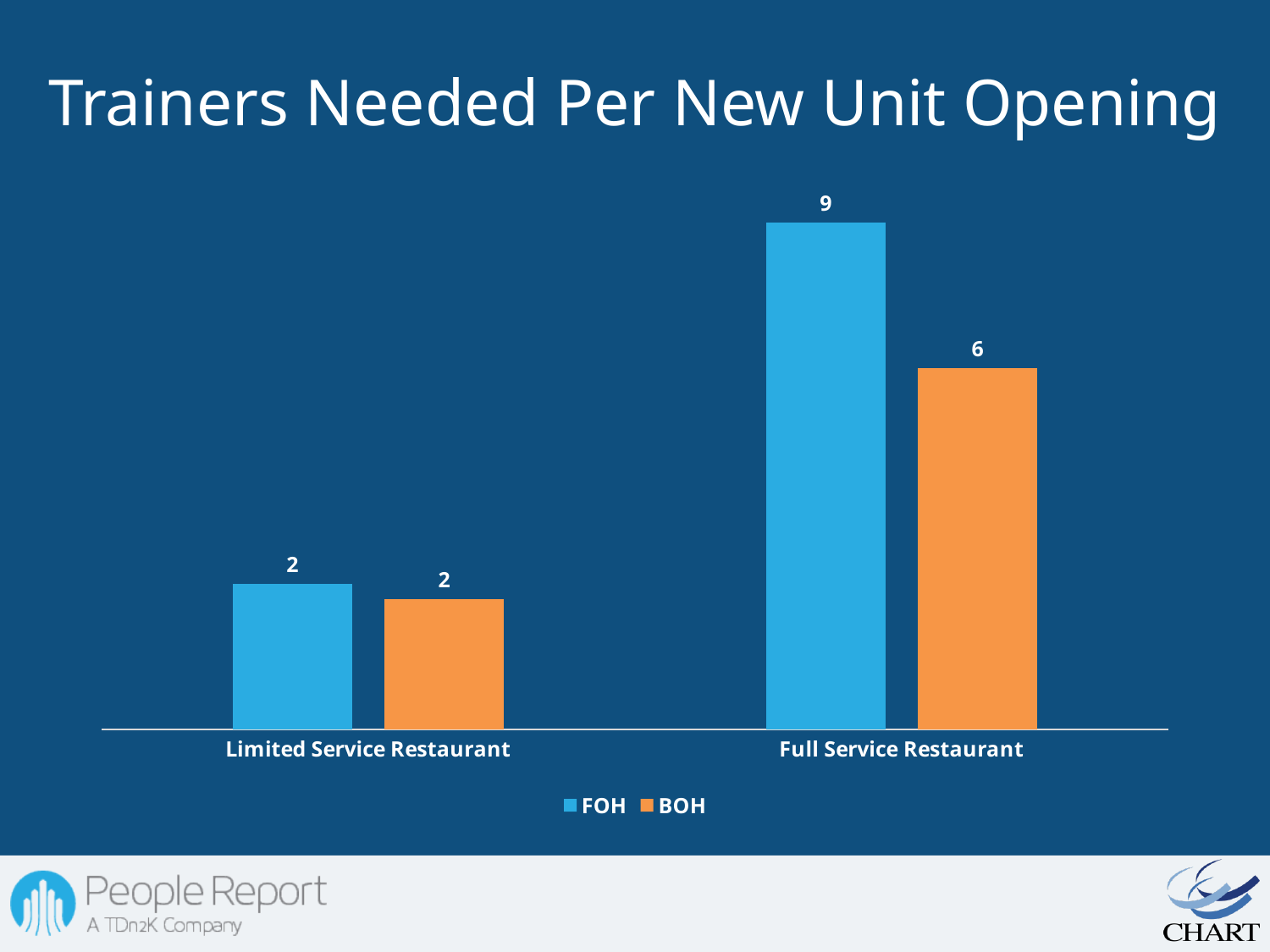
What is the difference between the FOH values for Full Service Restaurant and Limited Service Restaurant? 7 Which is larger for Full Service Restaurant, FOH or BOH? FOH How many categories are shown on the x axis? 2 Which category has the highest FOH value? Full Service Restaurant What is the difference between the FOH and BOH values for Full Service Restaurant? 3 What is the FOH value for Full Service Restaurant? 9 What is the FOH value for Limited Service Restaurant? 2 What is the BOH value for Limited Service Restaurant? 2 How many series does the legend list? 2 What kind of chart is shown on the slide? Bar chart Which category has the lowest BOH value? Limited Service Restaurant What is the BOH value for Full Service Restaurant? 6